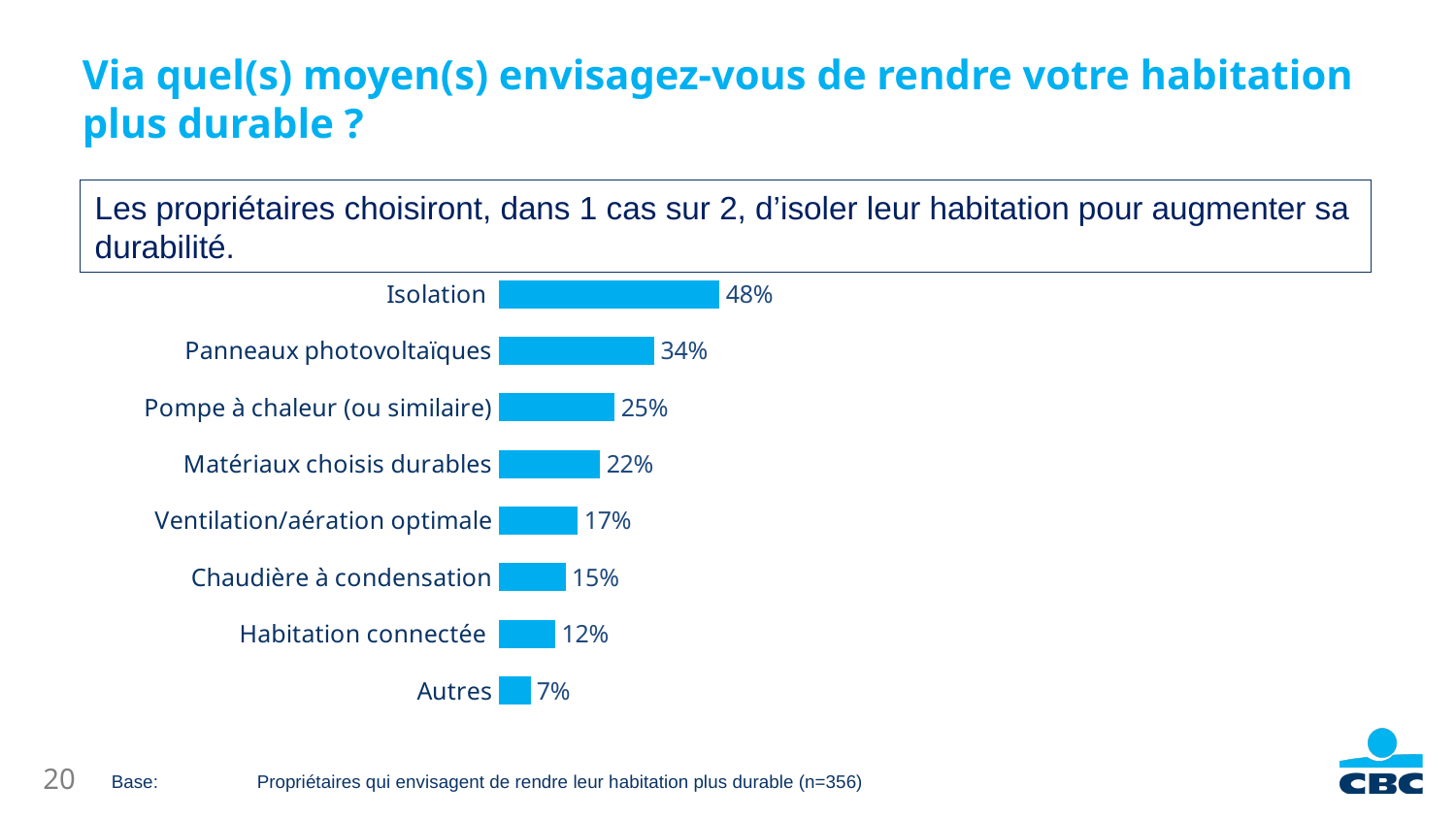
Which category has the highest value? Isolation What is the value for Isolation? 48% How many categories are shown in the chart? 8 Do the values rise or fall going from the top bar to the bottom bar? Fall What is the value for Chaudière à condensation? 15% What is the value for Habitation connectée? 12% What is the difference between the values for Pompe à chaleur (ou similaire) and Matériaux choisis durables? 3% Which is larger, the value for Ventilation/aération optimale or the value for Habitation connectée? Ventilation/aération optimale Which category has the lowest value? Autres What is the value for Panneaux photovoltaïques? 34% What kind of chart is shown on the slide? Bar chart What is the difference between the values for Isolation and Panneaux photovoltaïques? 14%